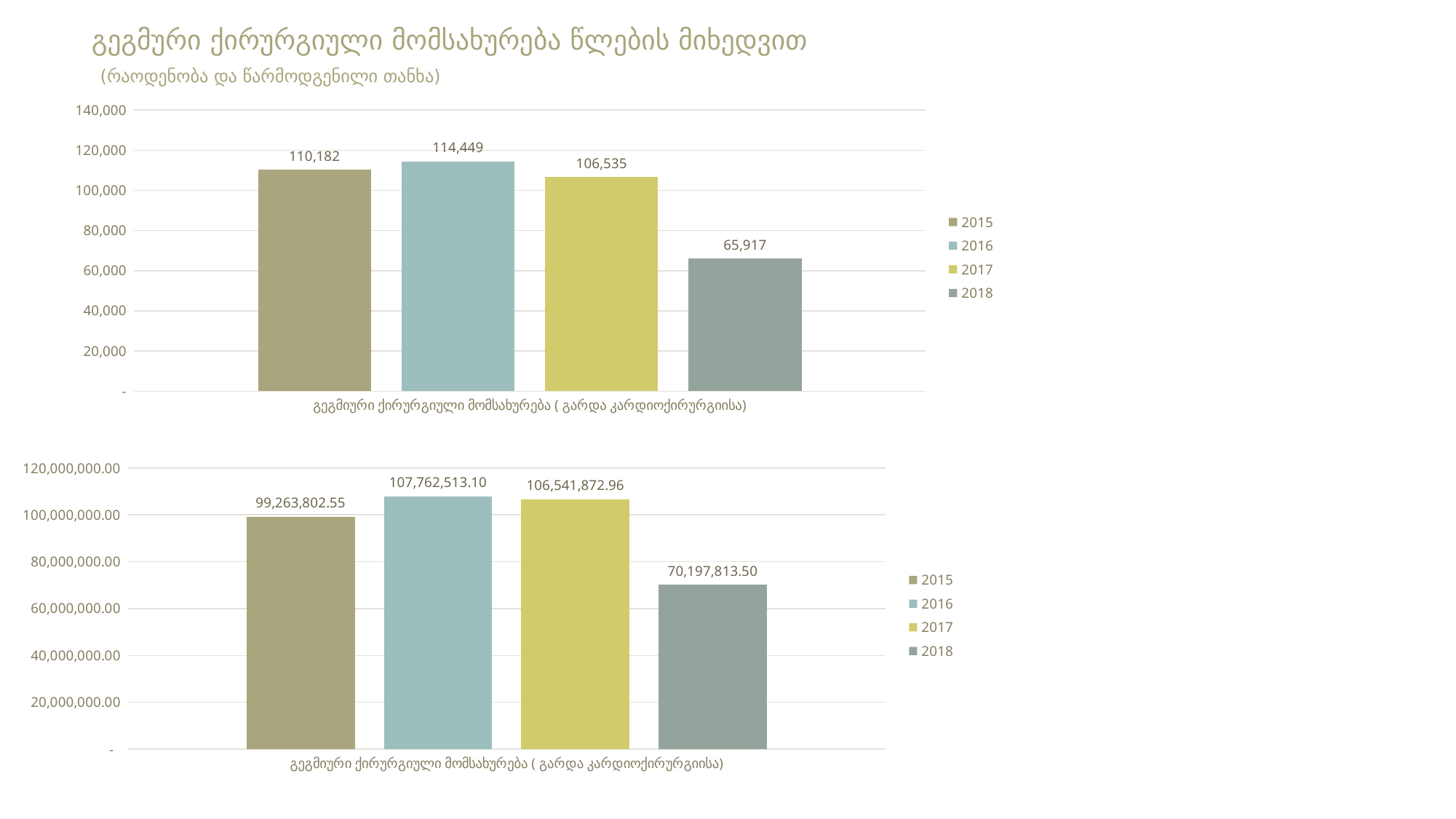
In the bottom chart, is the value for 2015 larger or smaller than the value for 2017? smaller In the bottom chart, what is the difference between the 2015 and 2018 values? 29,065,989.05 In the bottom chart, what is the value for 2015? 99,263,802.55 In the top chart, what is the difference between the 2016 and 2015 values? 4,267 In the bottom chart, which year has the highest value? 2016 How many series does the legend of the top chart list? 4 In the bottom chart, what is the value for 2018? 70,197,813.50 In the top chart, which year has the highest value? 2016 In the top chart, which year has the lowest value? 2018 In the top chart, what is the value for 2018? 65,917 What type of chart is the bottom chart? bar chart In the top chart, what is the value for 2016? 114,449